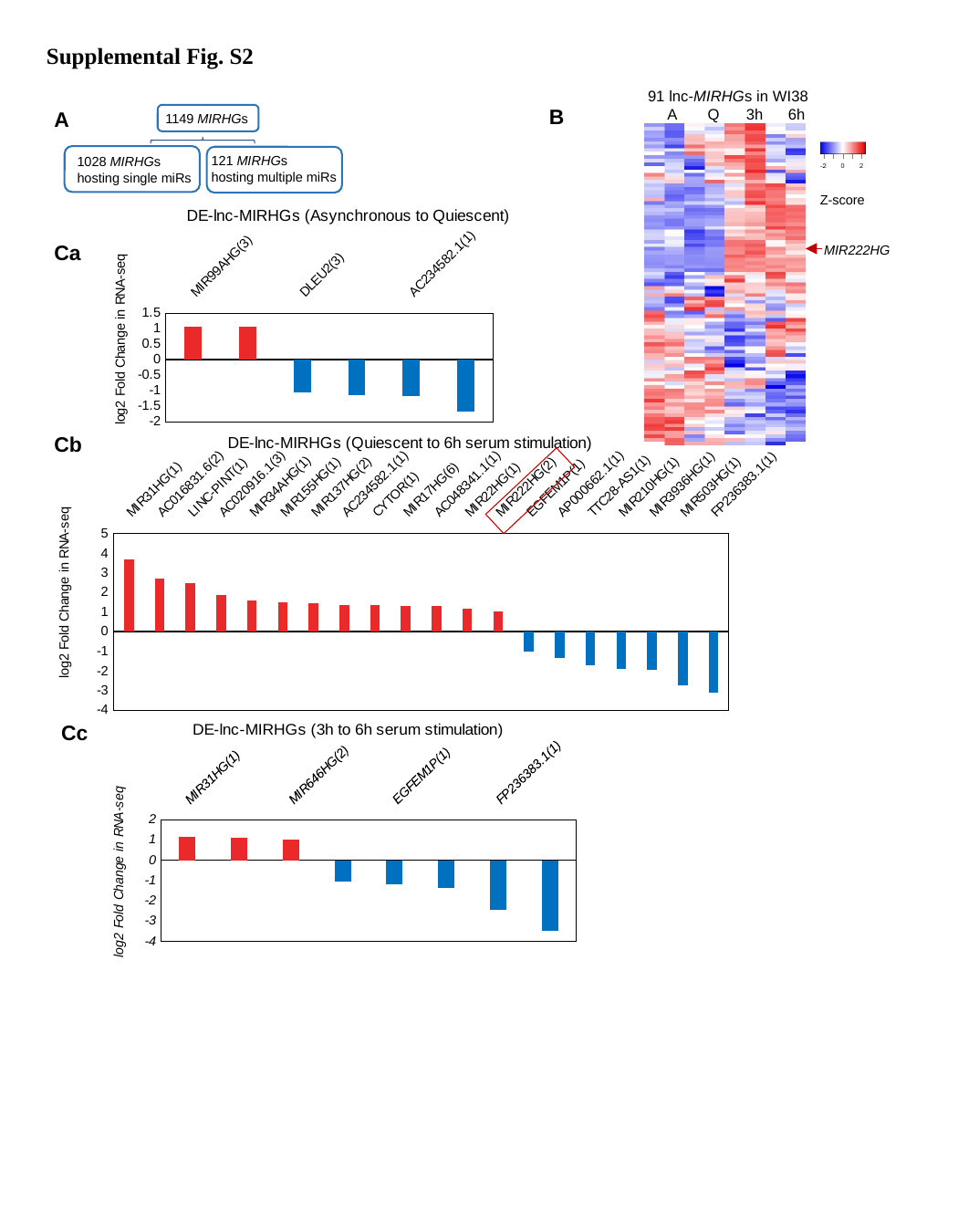
In the 'DE-lnc-MIRHGs (Quiescent to 6h serum stimulation)' chart (Cb), which is larger, the value for MIR31HG(1) or the value for MIR22HG(1)? MIR31HG(1) In the 'DE-lnc-MIRHGs (Quiescent to 6h serum stimulation)' chart (Cb), is the value for FP236383.1(1) greater or less than -2? less In the 'DE-lnc-MIRHGs (3h to 6h serum stimulation)' chart (Cc), how many bars are plotted? 8 In the 'DE-lnc-MIRHGs (Quiescent to 6h serum stimulation)' chart (Cb), which gene has the lowest log2 fold change? FP236383.1(1) In the 'DE-lnc-MIRHGs (Quiescent to 6h serum stimulation)' chart (Cb), is the value for MIR31HG(1) greater or less than 3? greater In the 'DE-lnc-MIRHGs (Asynchronous to Quiescent)' chart (Ca), how many bars are plotted? 6 What is the y-axis label of the 'DE-lnc-MIRHGs (Quiescent to 6h serum stimulation)' chart (Cb)? log2 Fold Change in RNA-seq In the 'DE-lnc-MIRHGs (Quiescent to 6h serum stimulation)' chart (Cb), how many genes (bars) are plotted? 20 In the 'DE-lnc-MIRHGs (Quiescent to 6h serum stimulation)' chart (Cb), do the values rise or fall from left to right along the x axis? fall In the 'DE-lnc-MIRHGs (3h to 6h serum stimulation)' chart (Cc), is the value of the rightmost bar greater or less than -3? less In the 'DE-lnc-MIRHGs (Quiescent to 6h serum stimulation)' chart (Cb), which gene has the highest log2 fold change? MIR31HG(1) What kind of chart is the 'DE-lnc-MIRHGs (Quiescent to 6h serum stimulation)' chart (Cb)? bar chart